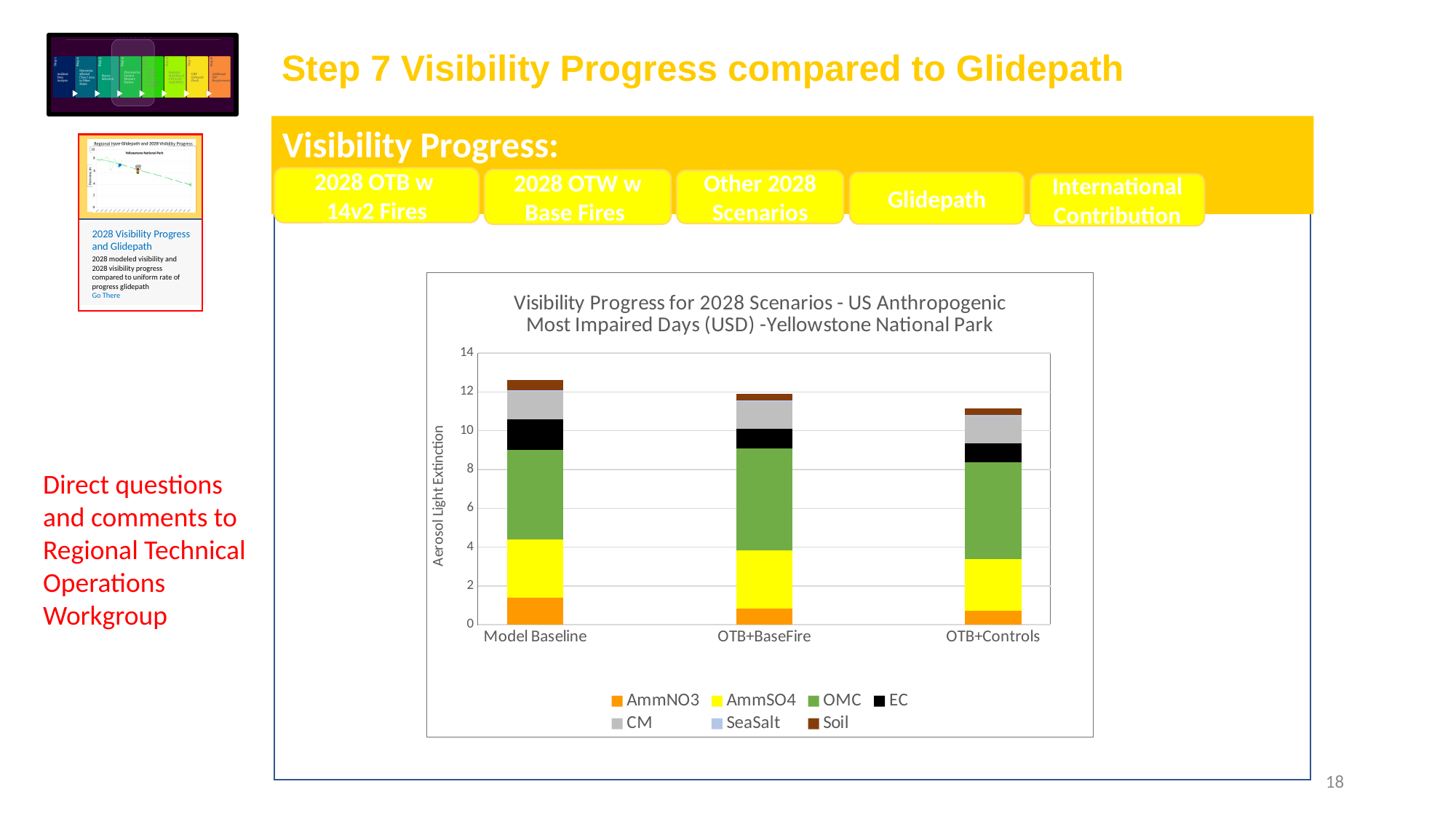
Which has a larger total aerosol light extinction, Model Baseline or OTB+Controls? Model Baseline Which series is shown in green in the chart legend? OMC Do the total bar heights rise or fall moving from Model Baseline to OTB+Controls along the x axis? Fall What is the label on the y axis of the chart? Aerosol Light Extinction Which scenario has the highest total aerosol light extinction? Model Baseline How many scenario categories are shown on the x axis of the chart? 3 How many series does the chart legend list? 7 Is the total bar height for OTB+BaseFire greater or less than 10? greater Is the total bar height for Model Baseline greater or less than 12? greater Which scenario has the lowest total aerosol light extinction? OTB+Controls What kind of chart is shown on the slide? Stacked bar chart Is the total bar height for OTB+Controls greater or less than 12? less